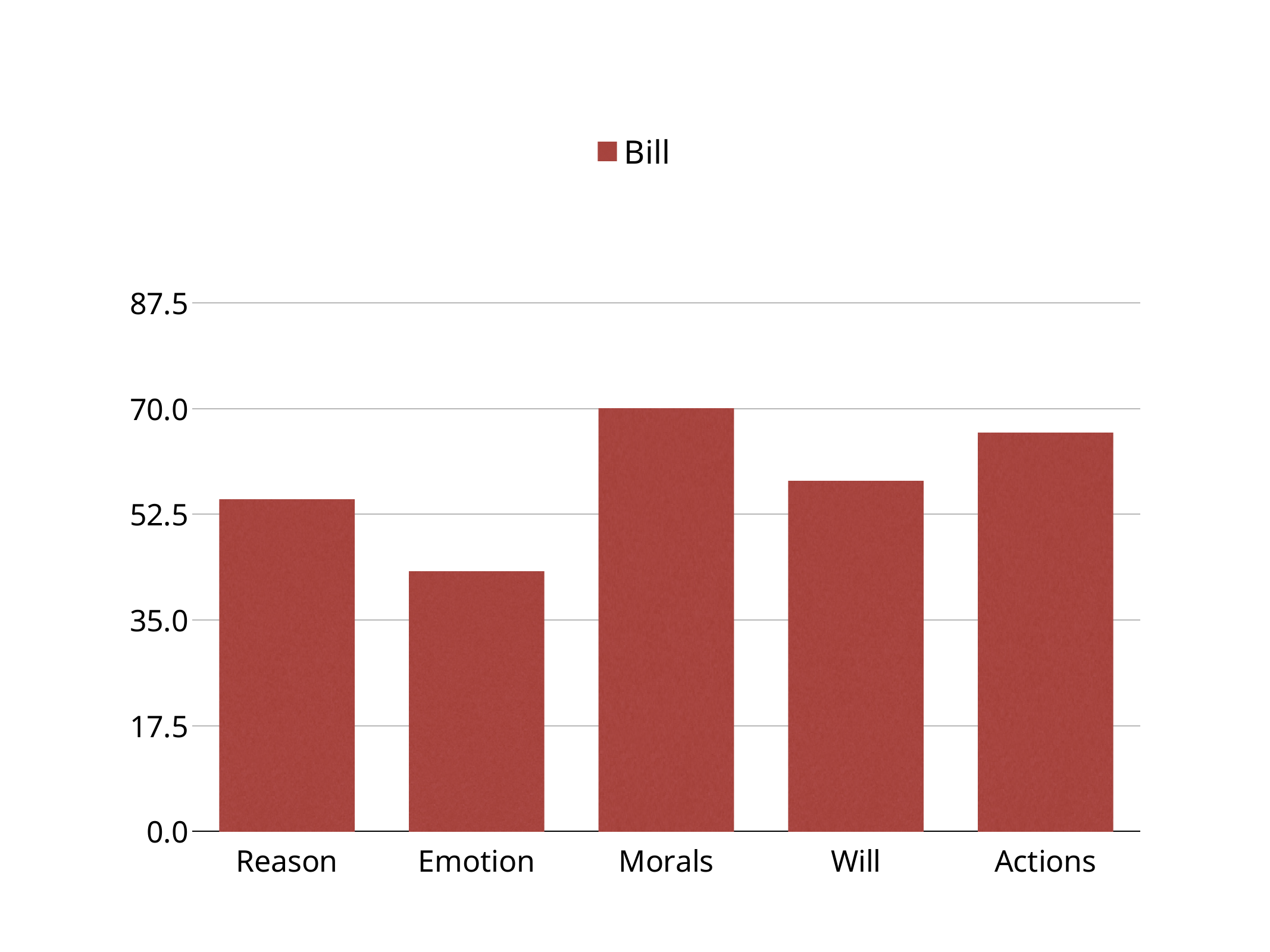
Which is larger, the value for Reason or the value for Emotion? Reason Is the value for Emotion greater or less than 52.5? less How many series does the legend list? 1 Is the value for Actions greater or less than 70.0? less How many categories are shown on the x axis? 5 Which category has the lowest value? Emotion Is the value for Reason greater or less than 52.5? greater Which category has the highest value? Morals What is the name of the series shown in the legend? Bill What is the value for Morals? 70.0 What kind of chart is shown on the slide? bar chart Which is larger, the value for Actions or the value for Will? Actions